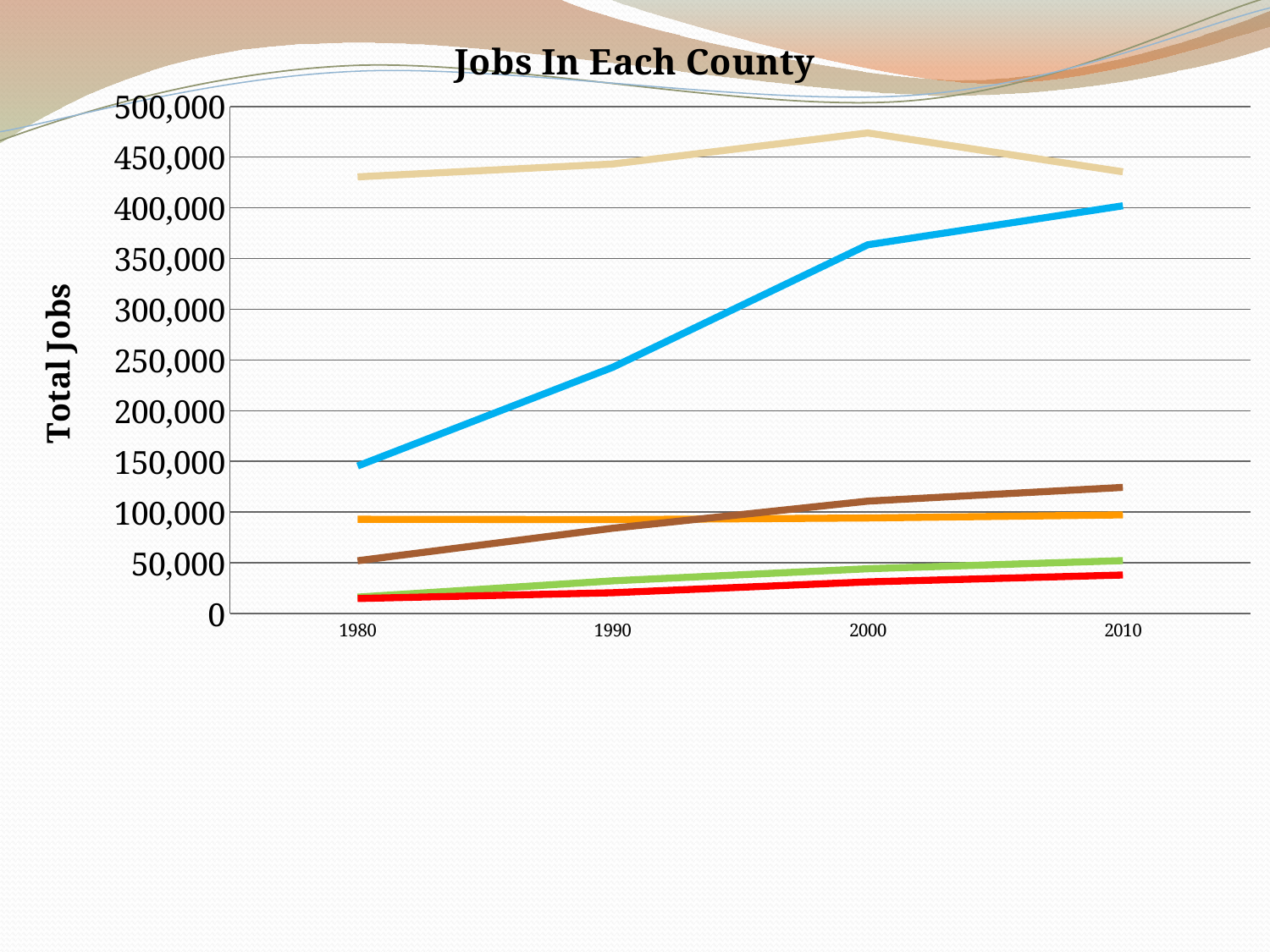
Is the value of the blue line in 2010 greater or less than 350,000? greater How many lines are plotted on the chart? 6 What is the label on the vertical axis of the chart? Total Jobs Is the value of the tan line in 2000 greater or less than 450,000? greater Does the brown line rise or fall from 1980 to 2010? rise Does the blue line rise or fall from 1980 to 2010? rise What kind of chart is shown on the slide? line chart In 2010, which line has the larger value, the blue line or the brown line? blue line Is the value of the blue line in 1980 greater or less than 200,000? less How many years are marked along the x axis of the chart? 4 What is the title of the chart? Jobs In Each County In which year does the tan line reach its highest value? 2000